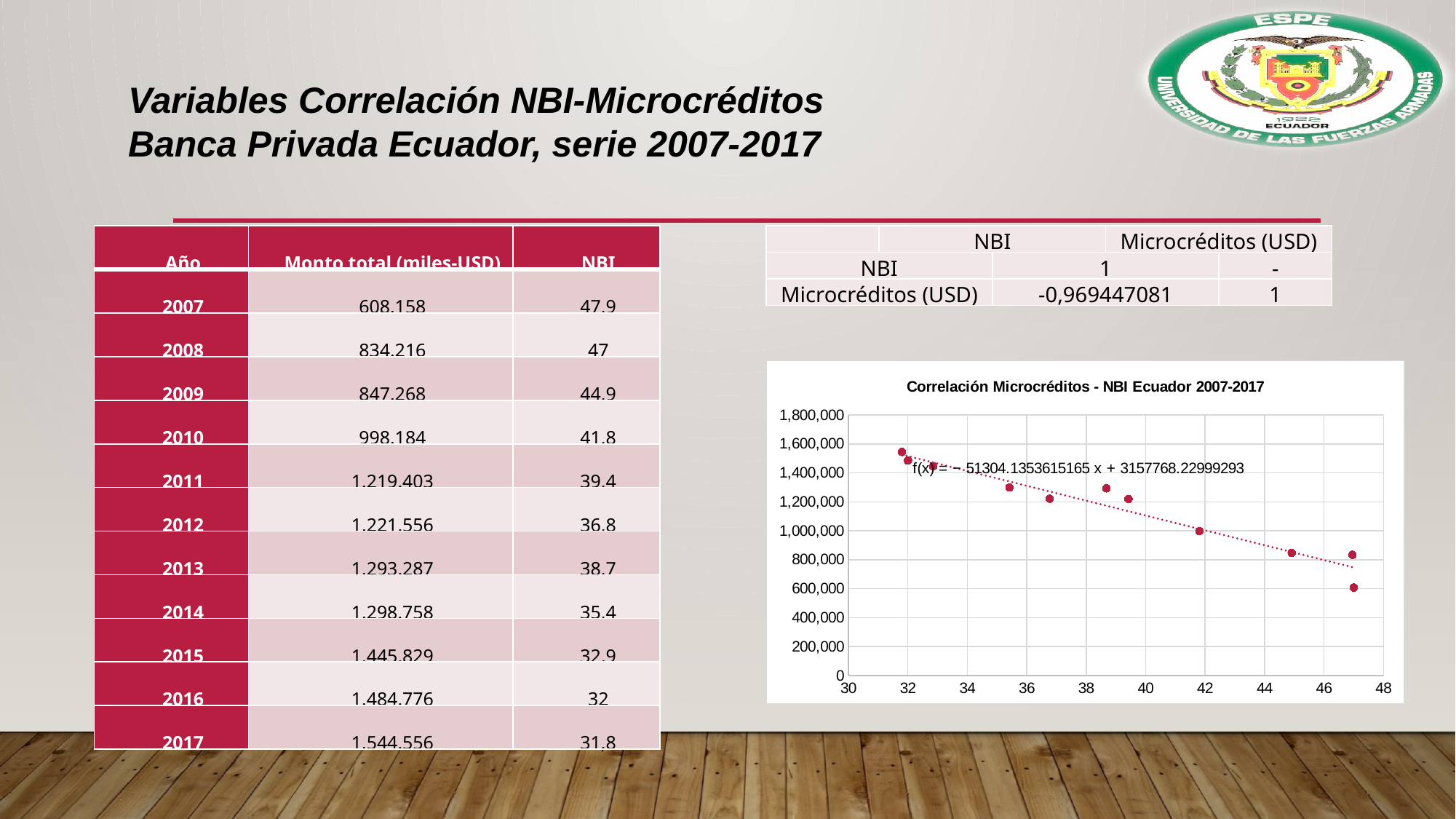
Is the value of the point plotted near x = 45 greater or less than 1,000,000? less Is the value of the point plotted near x = 35.4 greater or less than 1,400,000? less As the x-axis value increases, do the plotted values rise or fall? fall What is the title of the chart on the slide? Correlación Microcréditos - NBI Ecuador 2007-2017 Which is larger: the value of the point near x = 32 or the value of the point near x = 42? the point near x = 32 What is the intercept of the trendline equation displayed on the chart? 3157768.22999293 What is the highest value shown on the chart's vertical axis? 1,800,000 How many data points are plotted in the chart? 11 What kind of chart is shown on the slide? scatter chart Is the value of the lowest plotted point (near x = 47) greater or less than 800,000? less What is the slope of the trendline equation displayed on the chart? -51304.1353615165